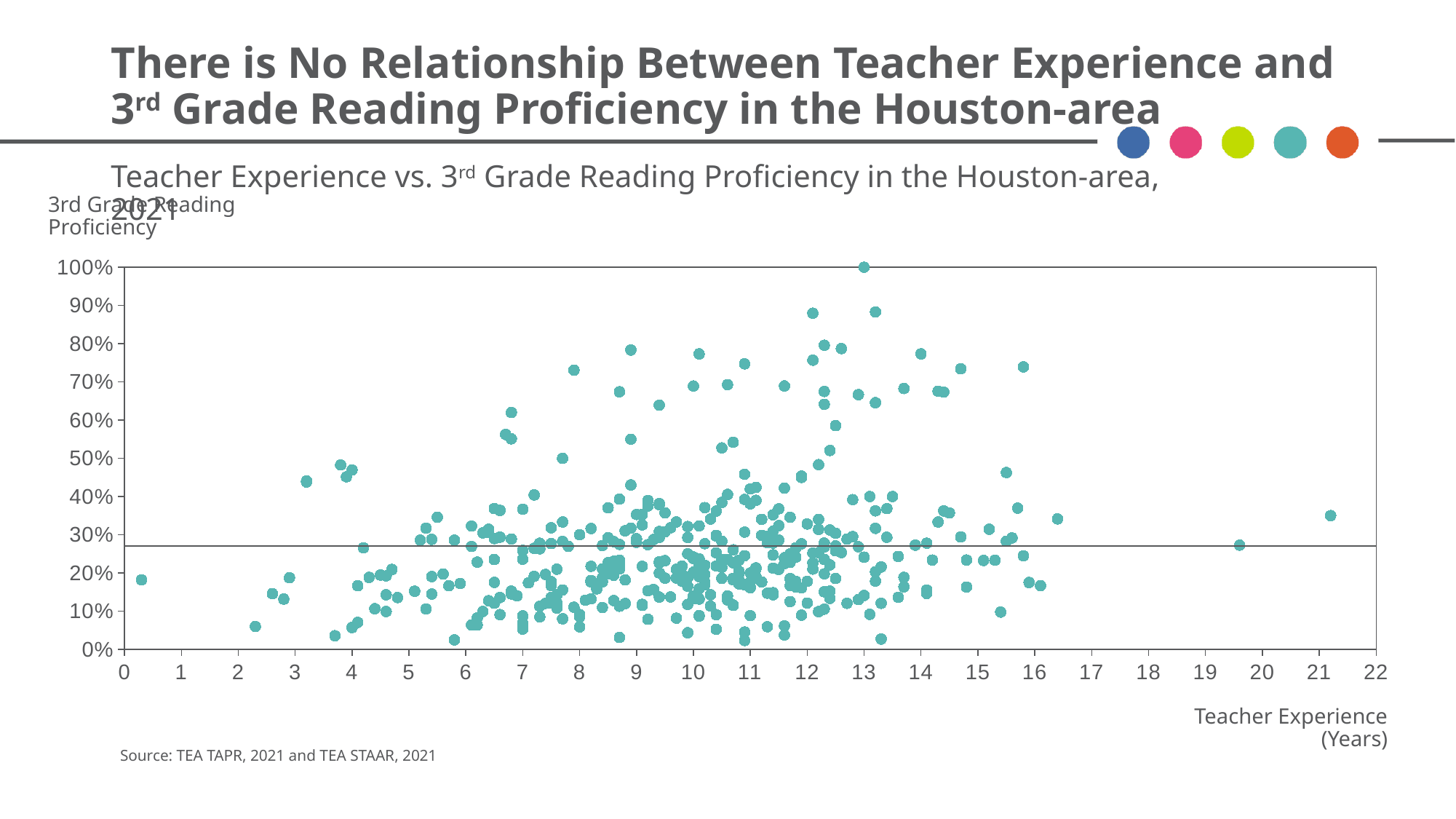
Is the point with the highest teacher experience (just over 21 years) greater or less than 40% reading proficiency? less What is the highest 3rd grade reading proficiency value reached by any point on the chart? 100% Is the point with the lowest teacher experience (under 1 year) greater or less than 30% reading proficiency? less How many data series are plotted on the chart? 1 What is the highest value shown on the y axis of the chart? 100% Do the points show a clear rising trend in reading proficiency as teacher experience increases? No What is the highest value shown on the x axis of the chart? 22 What kind of chart is shown on the slide? Scatter plot What is the title of the chart? Teacher Experience vs. 3rd Grade Reading Proficiency in the Houston-area, 2021 What is the source cited for the chart data? TEA TAPR, 2021 and TEA STAAR, 2021 What variable is plotted on the x axis of the chart? Teacher Experience (Years)